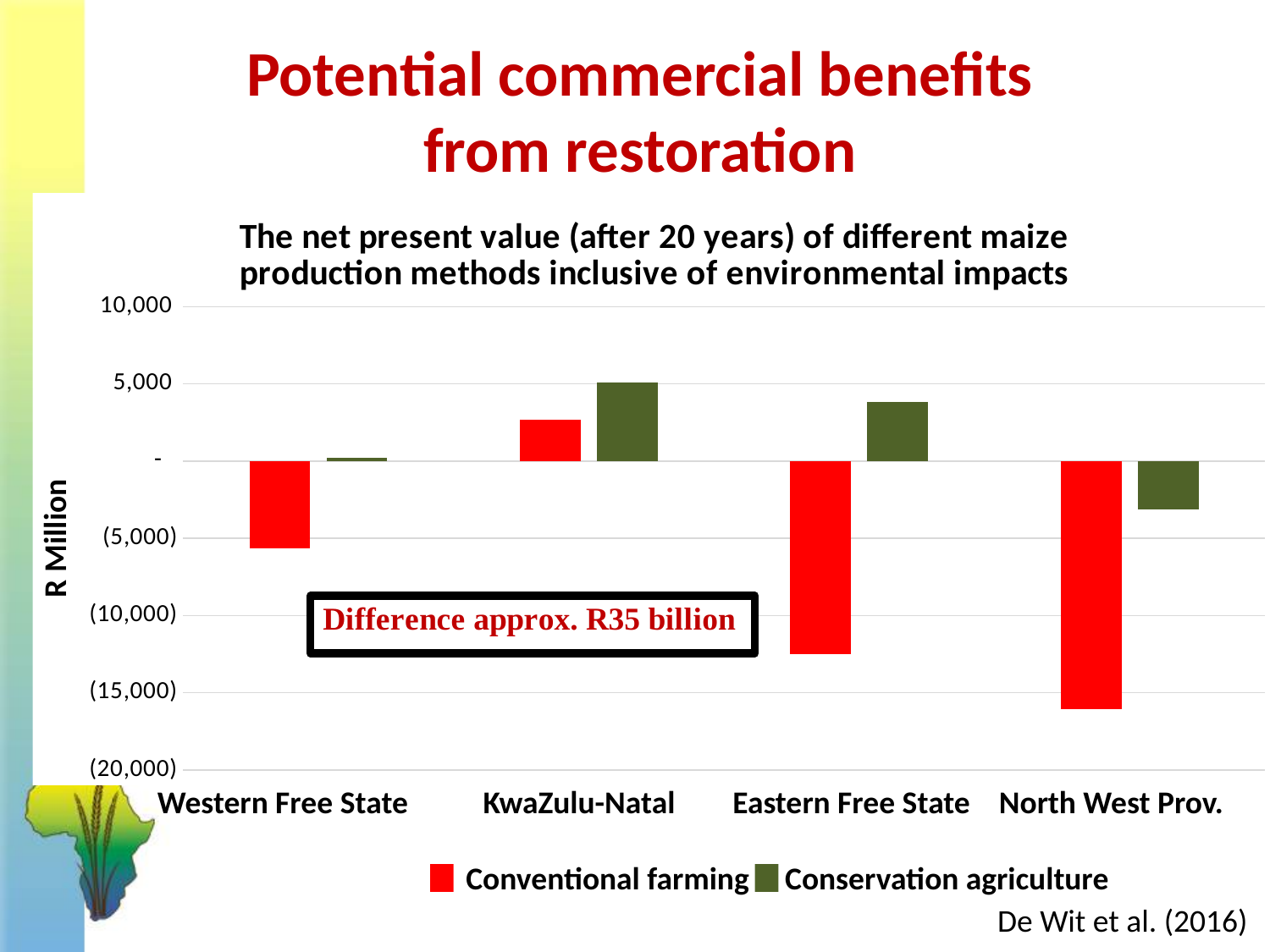
How many series does the legend list? 2 What kind of chart is shown on the slide? Bar chart How many regions (categories) are shown on the x axis? 4 Which region has the highest value for Conservation agriculture? KwaZulu-Natal Which region has the lowest value for Conventional farming? North West Prov. Is the Conventional farming value for Western Free State greater or less than (5,000)? less What is the label on the vertical axis? R Million Which region has the highest value for Conventional farming? KwaZulu-Natal Which colour represents Conservation agriculture in the legend? Green Is the Conventional farming value for Eastern Free State greater or less than (10,000)? less Is the Conventional farming value for North West Prov. greater or less than (15,000)? less For Eastern Free State, which is larger: Conventional farming or Conservation agriculture? Conservation agriculture